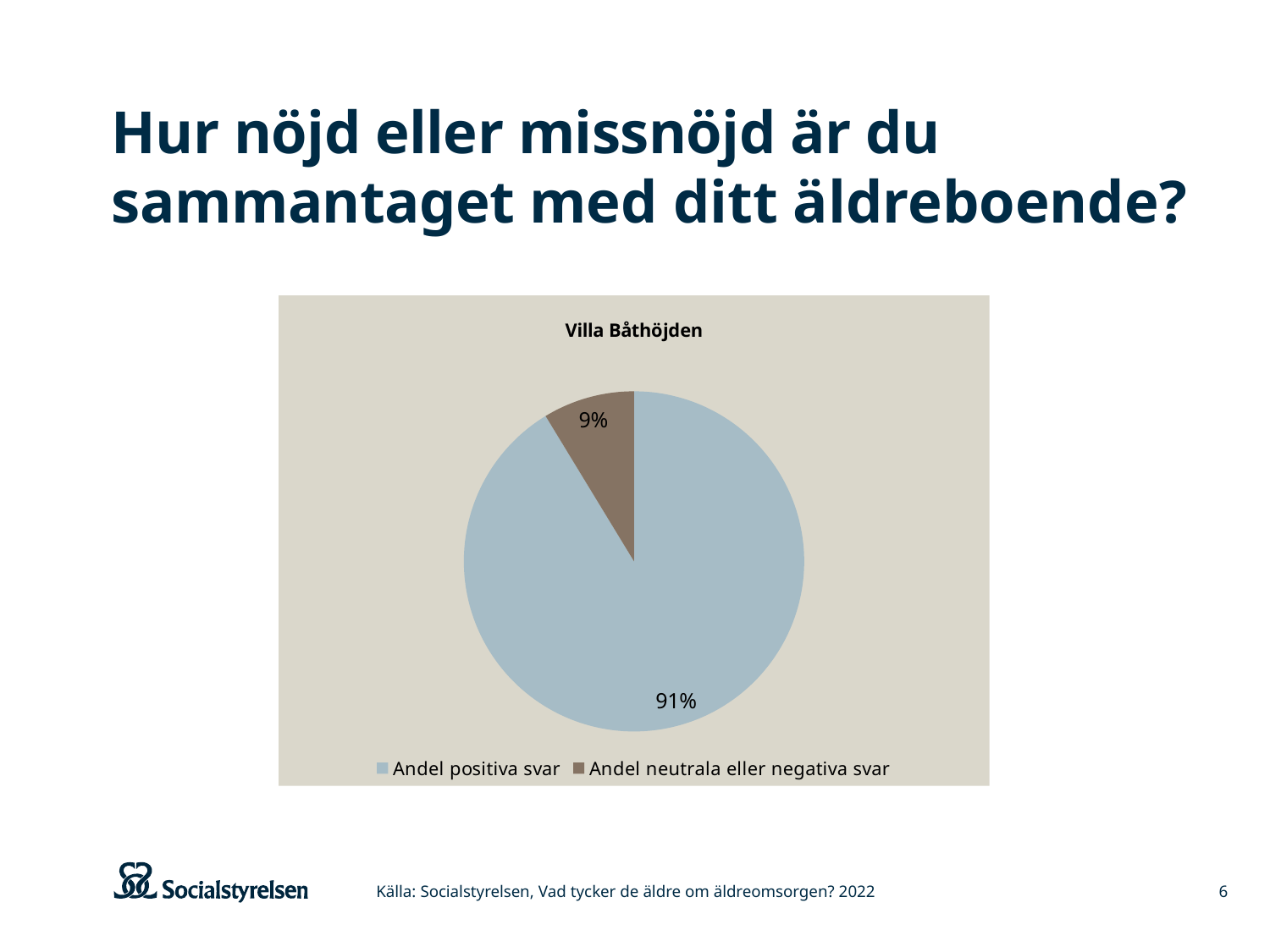
What share of the pie is 'Andel neutrala eller negativa svar'? 9% Which slice is the largest in the pie chart? Andel positiva svar What colour is the 'Andel positiva svar' slice? Light blue What is the total of the two slices shown in the pie chart? 100% How many entries does the legend list? 2 How many slices does the pie chart have? 2 Which slice is the smallest in the pie chart? Andel neutrala eller negativa svar What share of the pie is 'Andel positiva svar'? 91% Which is larger, 'Andel positiva svar' or 'Andel neutrala eller negativa svar'? Andel positiva svar What type of chart is shown on the slide? Pie chart What is the difference in percentage points between 'Andel positiva svar' and 'Andel neutrala eller negativa svar'? 82 percentage points What is the title of the chart? Villa Båthöjden